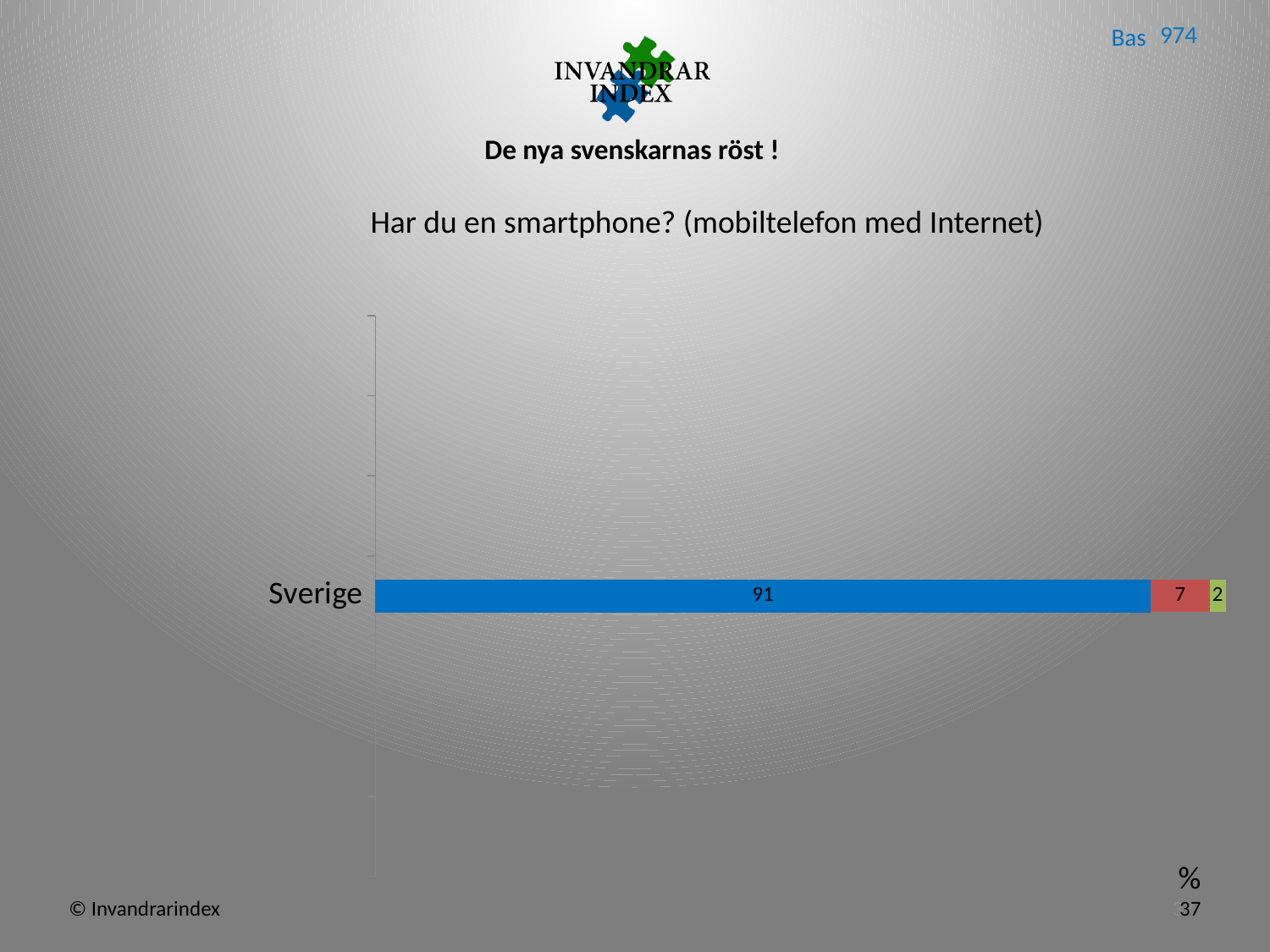
What is the label of the single category on the chart? Sverige What value is shown on the red segment of the Sverige bar? 7 How many categories are plotted on the chart? 1 What kind of chart is shown on the slide? A stacked horizontal bar chart What is the title of the chart? Har du en smartphone? (mobiltelefon med Internet) What is the difference between the blue segment and the red segment of the Sverige bar? 84 Which is larger in the Sverige bar, the red segment or the green segment? The red segment Which segment of the Sverige bar has the largest value? The blue segment (91) What value is shown on the green segment of the Sverige bar? 2 What value is shown on the blue segment of the Sverige bar? 91 Which segment of the Sverige bar has the smallest value? The green segment (2) What is the total of the three segments in the Sverige bar? 100